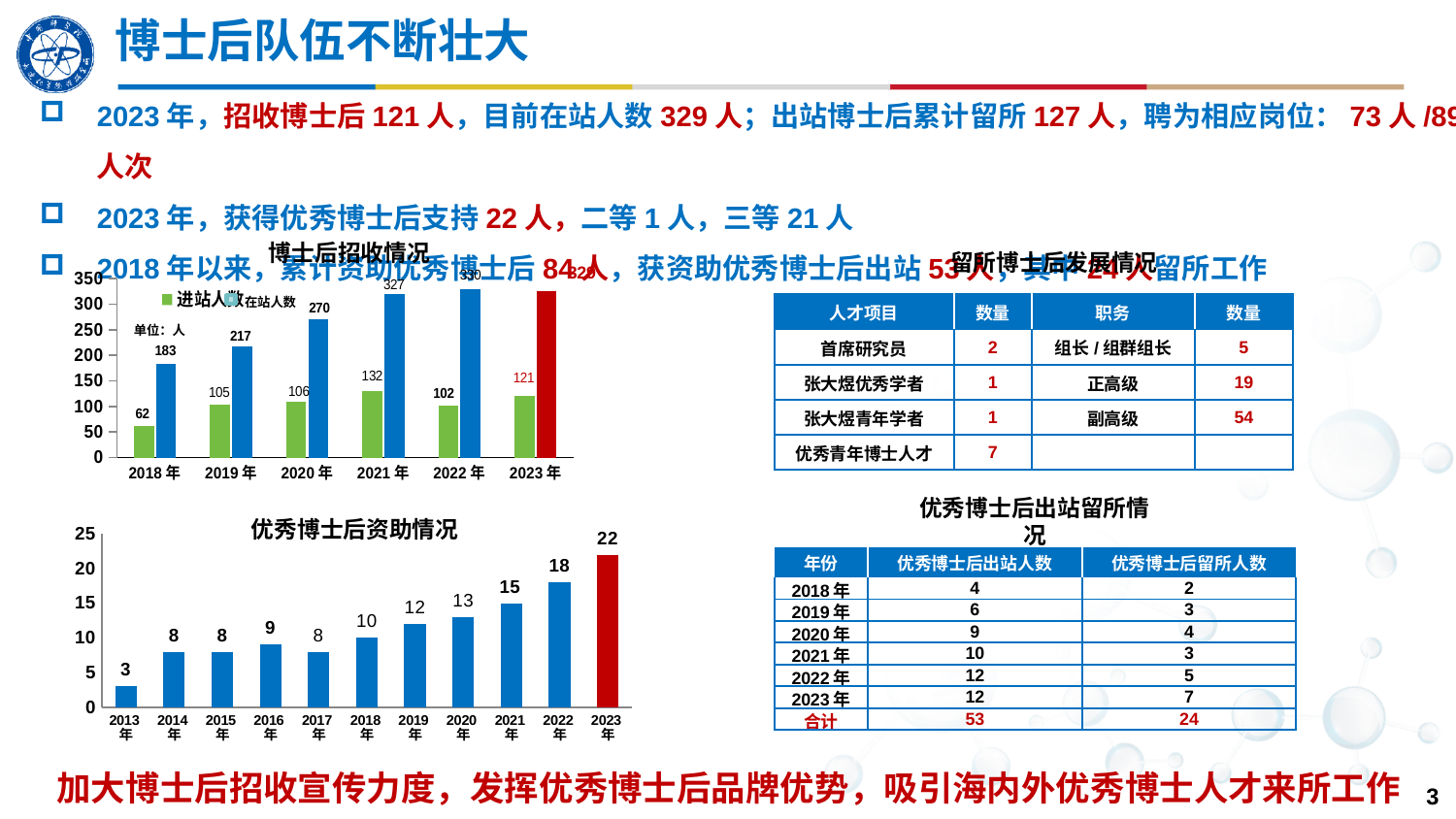
In the 优秀博士后资助情况 chart, which year has the lowest value? 2013年 What kind of chart is the 优秀博士后资助情况 chart? bar chart In the 博士后招收情况 chart, what is the 在站人数 value for 2021年? 327 In the 优秀博士后资助情况 chart, how many years are shown on the x axis? 11 In the 博士后招收情况 chart, what is the difference between the 在站人数 values for 2020年 and 2019年? 53 In the 优秀博士后资助情况 chart, which year has the highest value? 2023年 In the 博士后招收情况 chart, how many series does the legend list? 2 In the 博士后招收情况 chart, which year has the highest 进站人数? 2021年 In the 优秀博士后资助情况 chart, what is the value for 2020年? 13 In the 博士后招收情况 chart, is the 在站人数 value for 2022年 greater or less than 300? greater In the 优秀博士后资助情况 chart, what is the difference between the values for 2023年 and 2022年? 4 In the 博士后招收情况 chart, what is the 进站人数 value for 2018年? 62